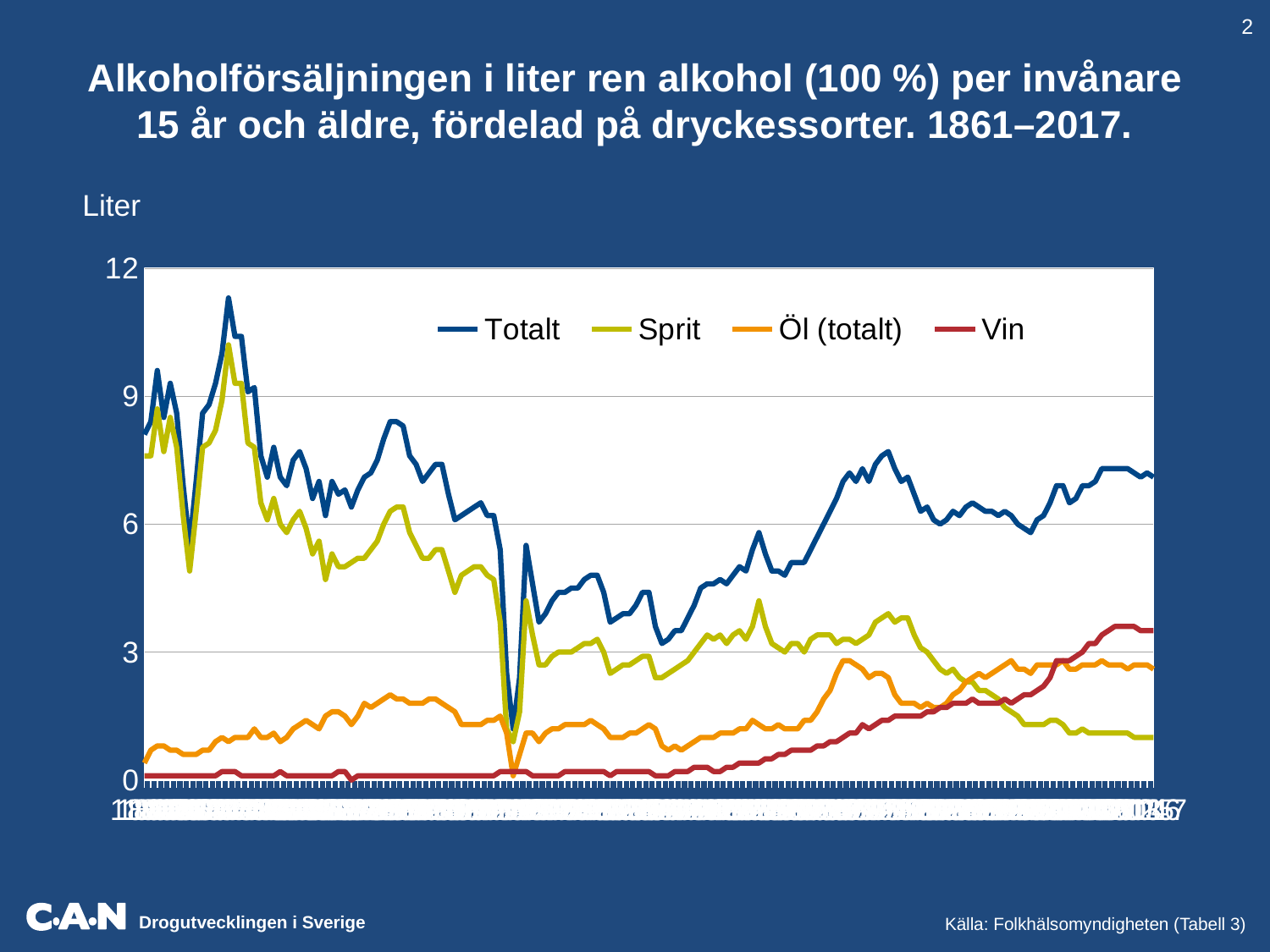
Which series reaches the highest value anywhere on the chart? Totalt What kind of chart is shown on the slide? line chart Is the highest value reached by the Vin line greater or less than 6? less Which series are listed in the legend? Totalt, Sprit, Öl (totalt), Vin What is the unit shown on the y axis label? Liter Is the highest value reached by the Öl (totalt) line greater or less than 6? less How many series does the legend list? 4 Does the Vin line generally rise or fall from the left to the right of the chart? rise Is the value of the Sprit line at the right end of the chart greater or less than 3? less At the right end of the chart, which is larger: the Vin value or the Sprit value? Vin